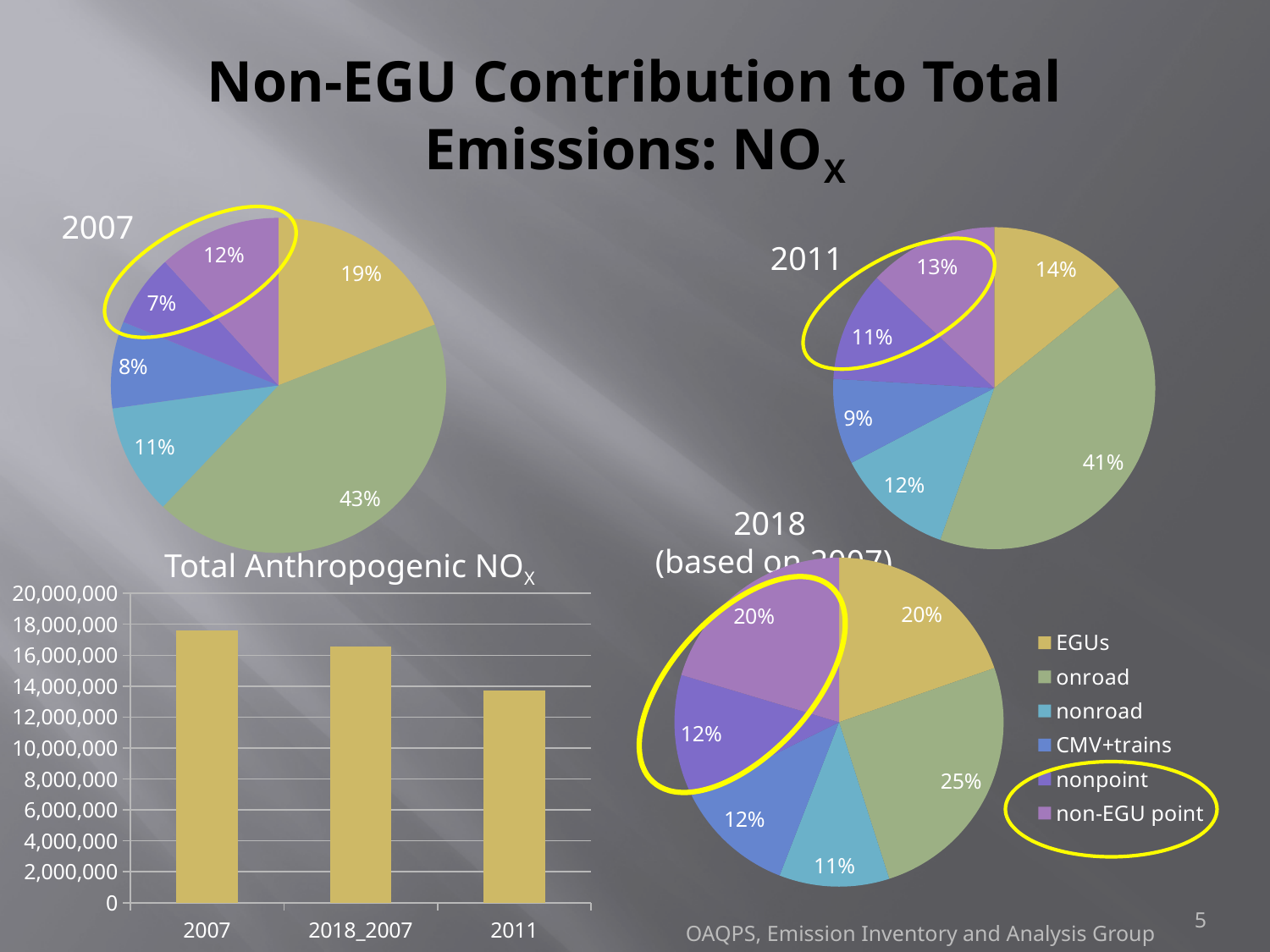
In the Total Anthropogenic NOx chart, is the value for 2011 greater or less than 14,000,000? less In the 2018 (based on 2007) pie chart, what share is shown for nonroad? 11% In the Total Anthropogenic NOx chart, is the value for 2007 greater or less than 16,000,000? greater In the Total Anthropogenic NOx chart, which category has the lowest bar? 2011 In the 2007 pie chart, which is larger, the nonpoint share or the CMV+trains share? CMV+trains In the 2007 pie chart, what share of emissions comes from onroad sources? 43% How many categories does the pie chart legend list? 6 In the 2018 (based on 2007) pie chart, what is the difference between the onroad share and the EGUs share? 5% In the 2011 pie chart, what share is attributed to EGUs? 14% In the 2007 pie chart, what percentage is shown for the non-EGU point slice? 12% In the 2011 pie chart, which category has the largest share? onroad What type of chart is the Total Anthropogenic NOx chart? bar chart